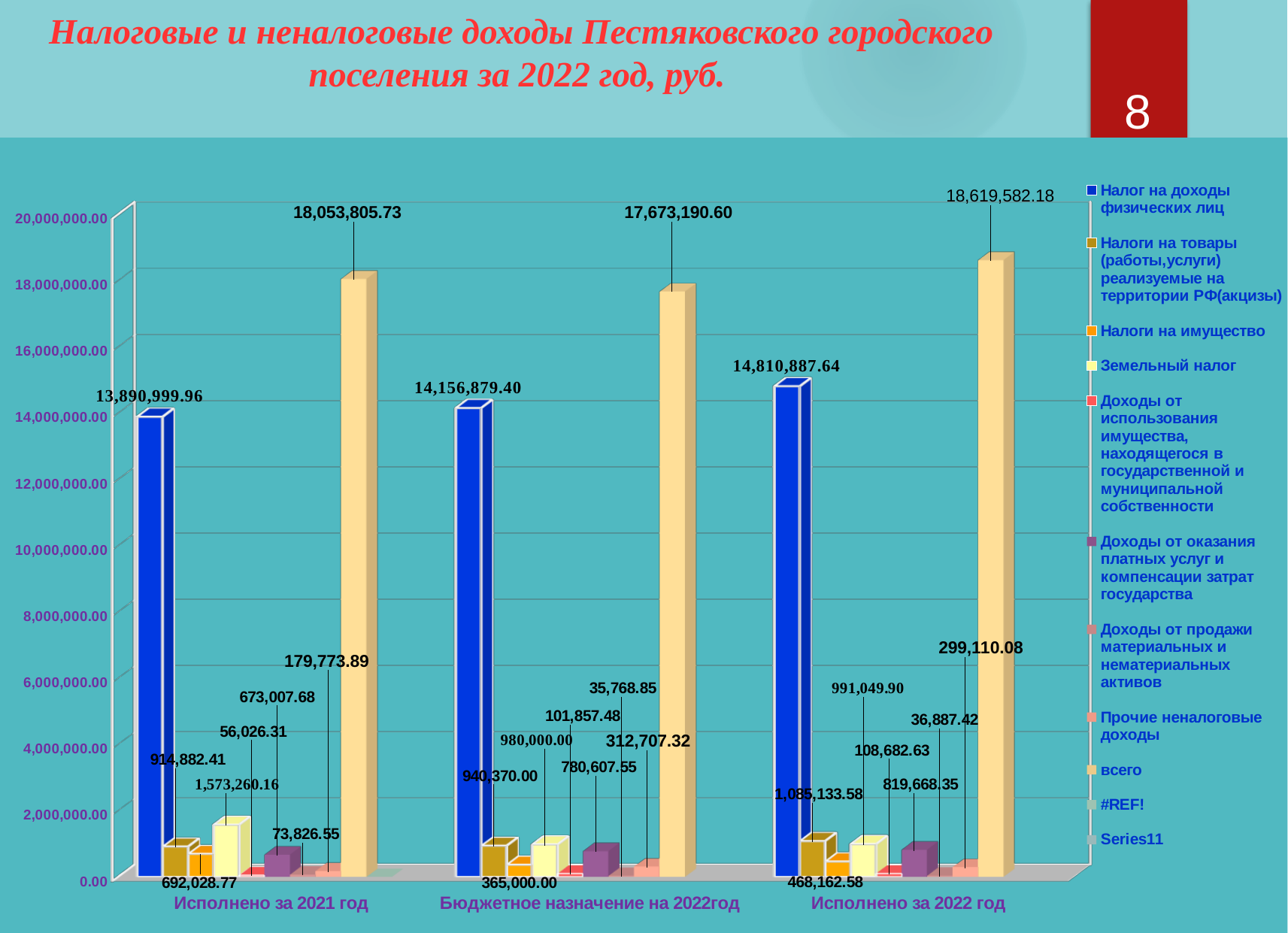
Which is larger: 'всего' for 'Исполнено за 2021 год' or 'всего' for 'Бюджетное назначение на 2022год'? Исполнено за 2021 год In which category is the 'всего' value the highest? Исполнено за 2022 год How many series does the chart legend list? 11 What is the value of 'Налог на доходы физических лиц' for 'Исполнено за 2021 год'? 13,890,999.96 What is the difference between 'всего' for 'Исполнено за 2022 год' and 'всего' for 'Исполнено за 2021 год'? 565,776.45 What is the value of 'всего' for 'Бюджетное назначение на 2022год'? 17,673,190.60 What is the value of 'всего' for 'Исполнено за 2022 год'? 18,619,582.18 What is the difference between 'Налог на доходы физических лиц' for 'Исполнено за 2022 год' and for 'Исполнено за 2021 год'? 919,887.68 What type of chart is shown on the slide? bar chart Does the value of 'Налог на доходы физических лиц' rise or fall from 'Исполнено за 2021 год' to 'Исполнено за 2022 год'? rise What is the value of 'Налог на доходы физических лиц' for 'Исполнено за 2022 год'? 14,810,887.64 How many categories are shown along the x axis of the chart? 3